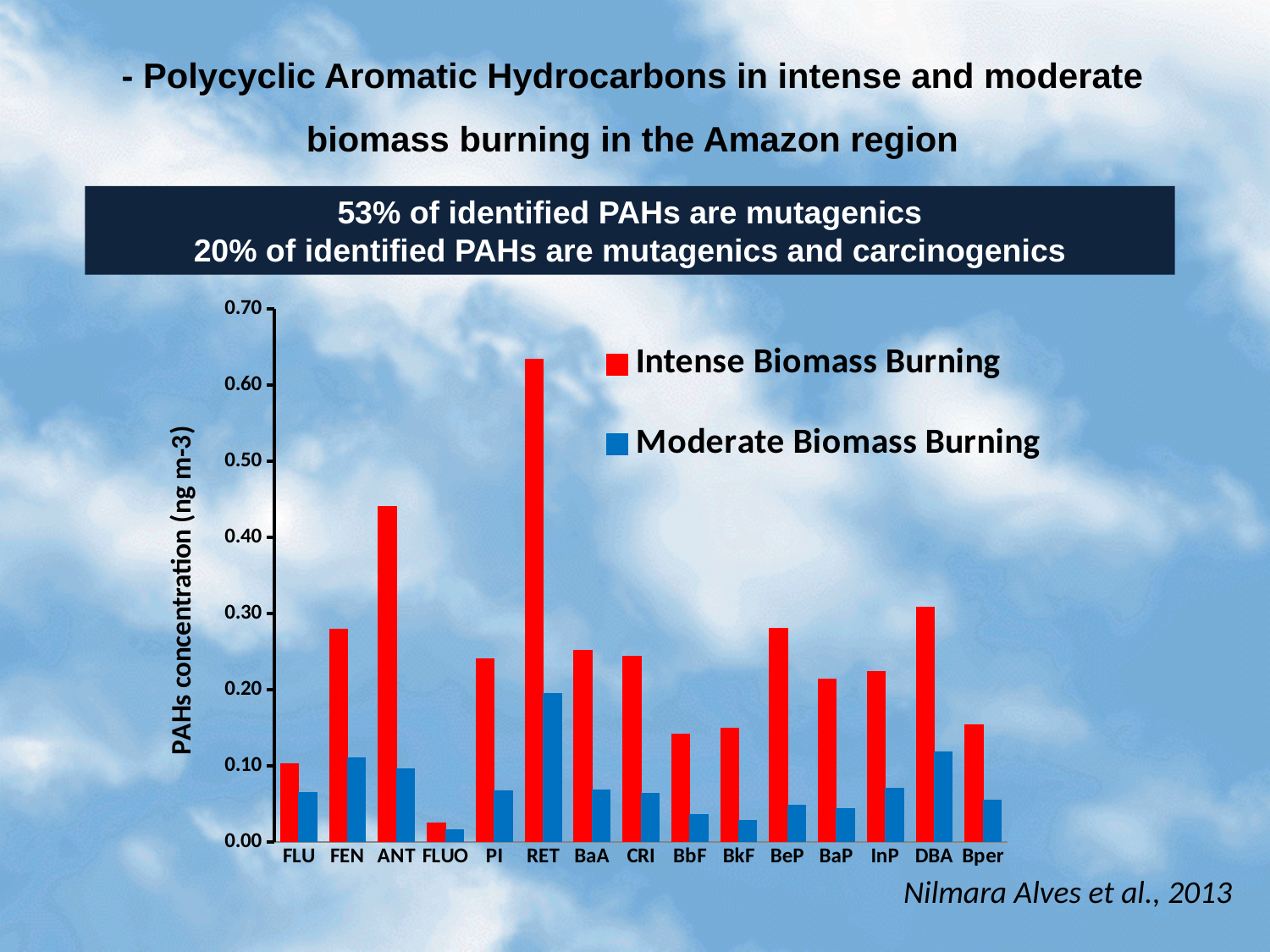
What is the label of the y axis? PAHs concentration (ng m-3) Which category has the highest Moderate Biomass Burning value? RET Which is larger for Intense Biomass Burning: BeP or BaP? BeP Which is larger for Moderate Biomass Burning: FEN or FLU? FEN What type of chart is shown on the slide? bar chart Which category has the highest Intense Biomass Burning value? RET Which category has the lowest Intense Biomass Burning value? FLUO How many PAH categories are shown on the x axis? 15 Is the Intense Biomass Burning value for ANT greater or less than 0.40? greater Is the Moderate Biomass Burning value for DBA greater or less than 0.10? greater Is the Intense Biomass Burning value for FEN greater or less than 0.30? less How many series does the legend list? 2